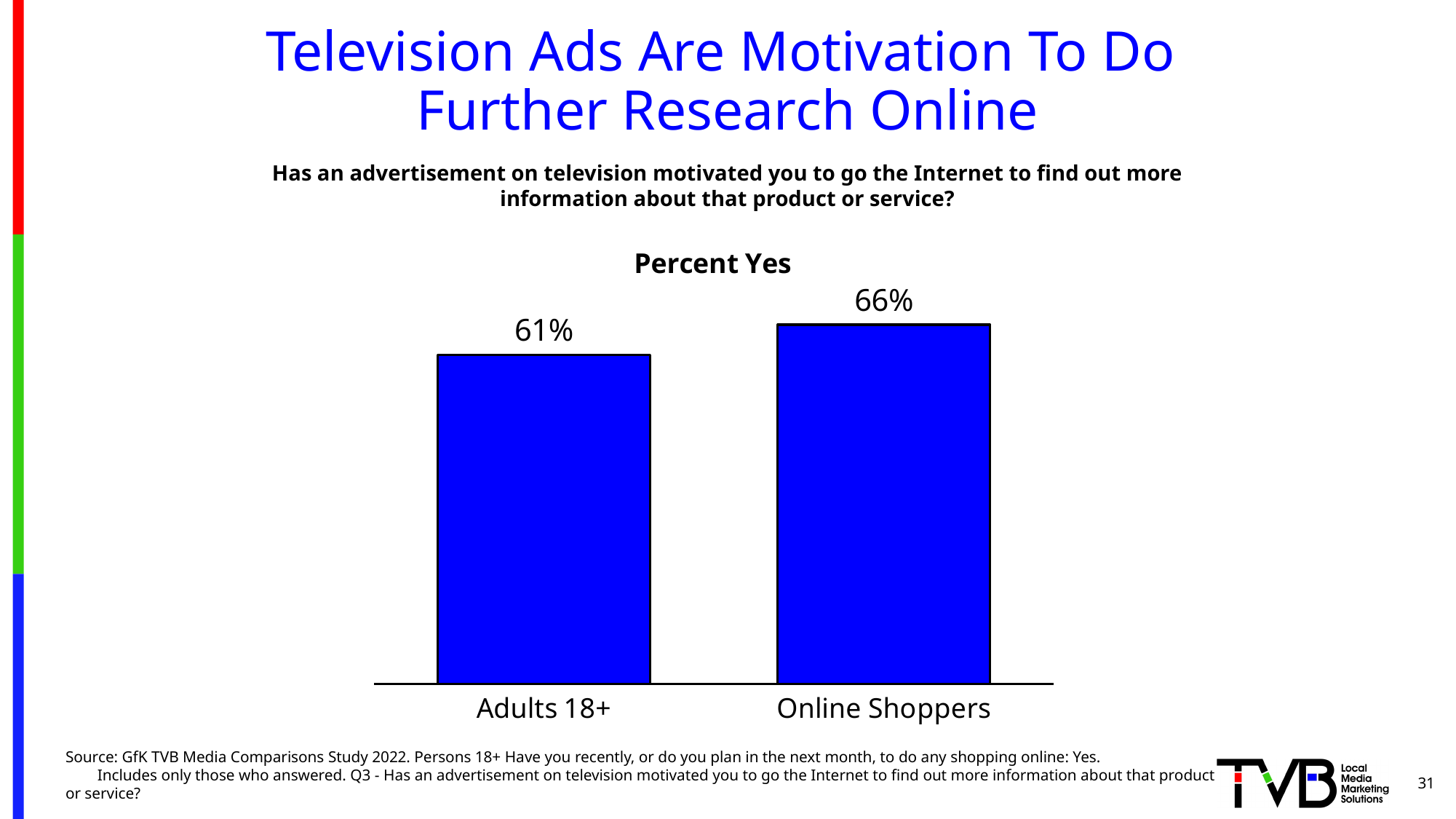
Which category has the highest Percent Yes value? Online Shoppers What kind of chart is shown on the slide? Bar chart What is the difference in Percent Yes between Online Shoppers and Adults 18+? 5% What is the title of the chart? Percent Yes How many categories are shown in the chart? 2 What is the Percent Yes value for Online Shoppers? 66% Which category has the lowest Percent Yes value? Adults 18+ What is the Percent Yes value for Adults 18+? 61% Which is larger, the Percent Yes for Adults 18+ or for Online Shoppers? Online Shoppers What colour are the bars in the chart? Blue